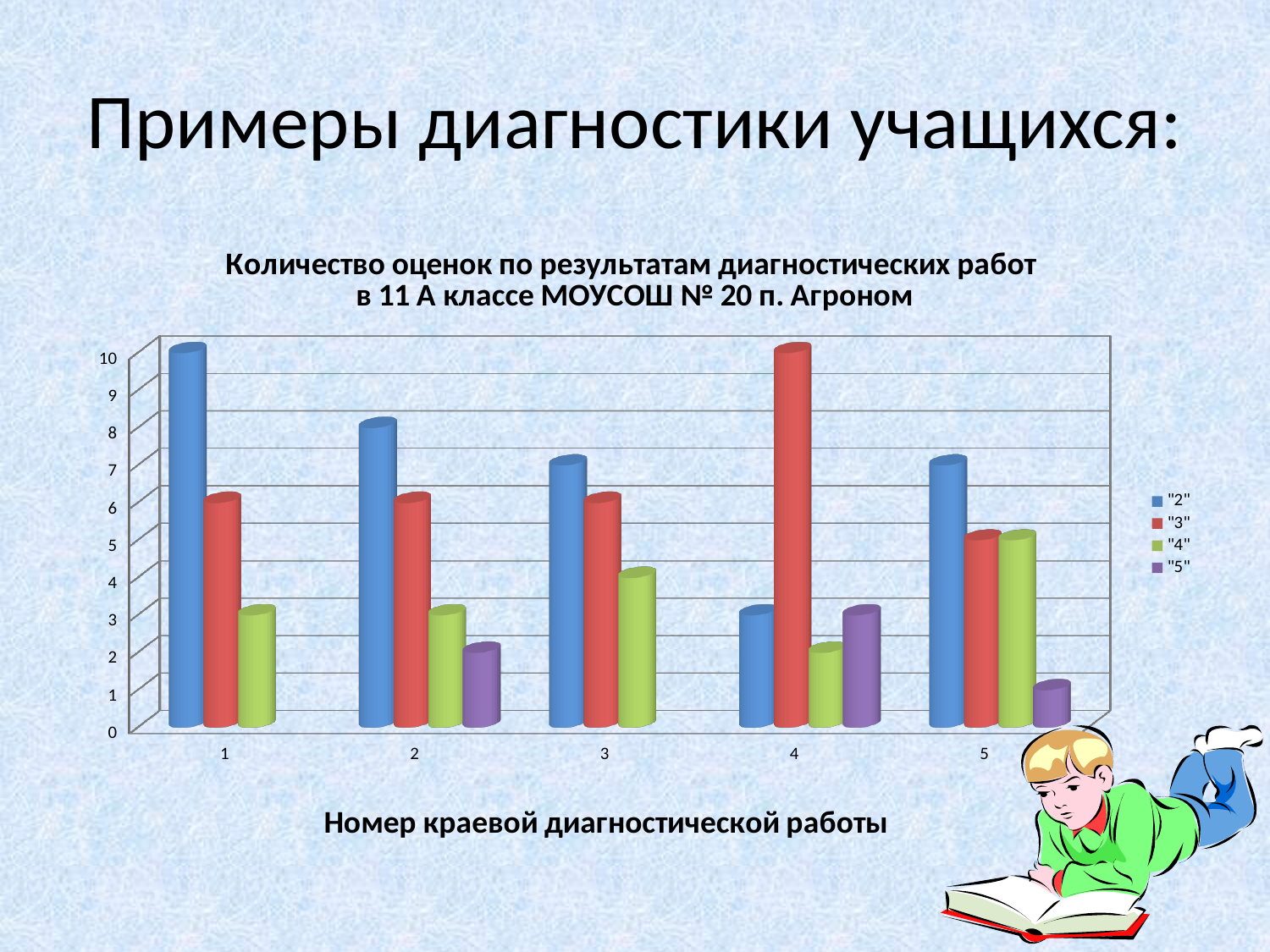
How many series does the legend list? 4 Which series has the highest value for diagnostic work 1? "2" What colour are the bars for series "3" in the legend? red Which series has the highest value for diagnostic work 4? "3" For diagnostic work 2, which is larger: the value for series "2" or the value for series "5"? "2" Is the value for series "4" at diagnostic work 4 greater or less than 4? less Which series has the lowest value for diagnostic work 5? "5" What is the label of the x axis? Номер краевой диагностической работы How many diagnostic work numbers are shown on the x axis? 5 What kind of chart is shown on the slide? bar chart Is the value for series "3" at diagnostic work 4 greater or less than 8? greater Is the value for series "2" at diagnostic work 1 greater or less than 8? greater